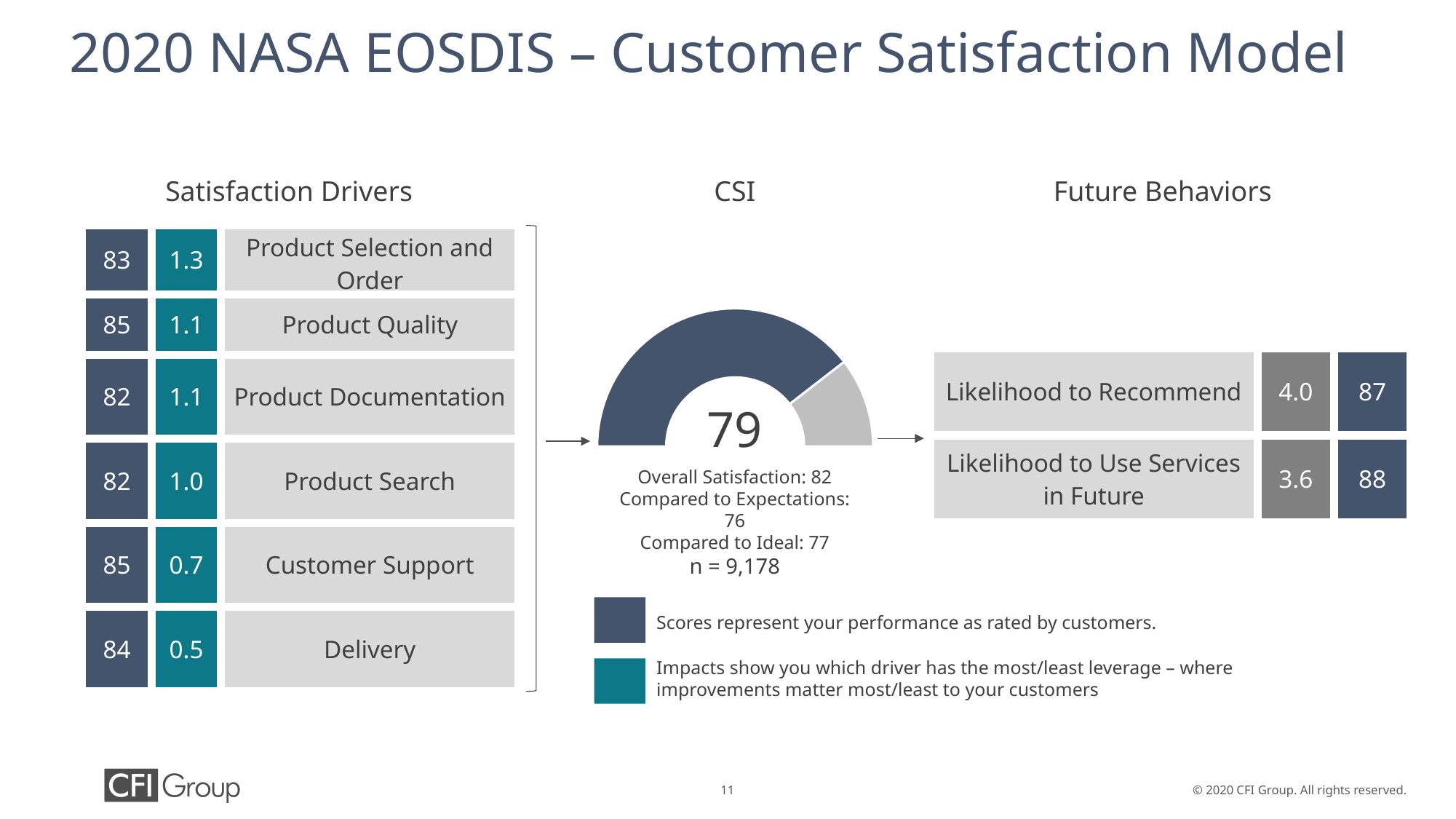
What is the sample size (n) shown below the CSI gauge? 9,178 What is the Compared to Expectations value listed below the CSI gauge? 76 What is the Overall Satisfaction value listed below the CSI gauge? 82 What kind of chart is used to display the CSI score? gauge chart What is the score for Product Documentation in the Satisfaction Drivers section? 82 What value is shown in the centre of the CSI gauge chart? 79 Which satisfaction driver has the lowest impact value? Delivery How many satisfaction drivers are listed in the Satisfaction Drivers section? 6 In the Future Behaviors section, which has the higher score: Likelihood to Recommend or Likelihood to Use Services in Future? Likelihood to Use Services in Future What is the difference between the score for Product Quality and the score for Product Search? 3 Which satisfaction driver has the highest impact value? Product Selection and Order